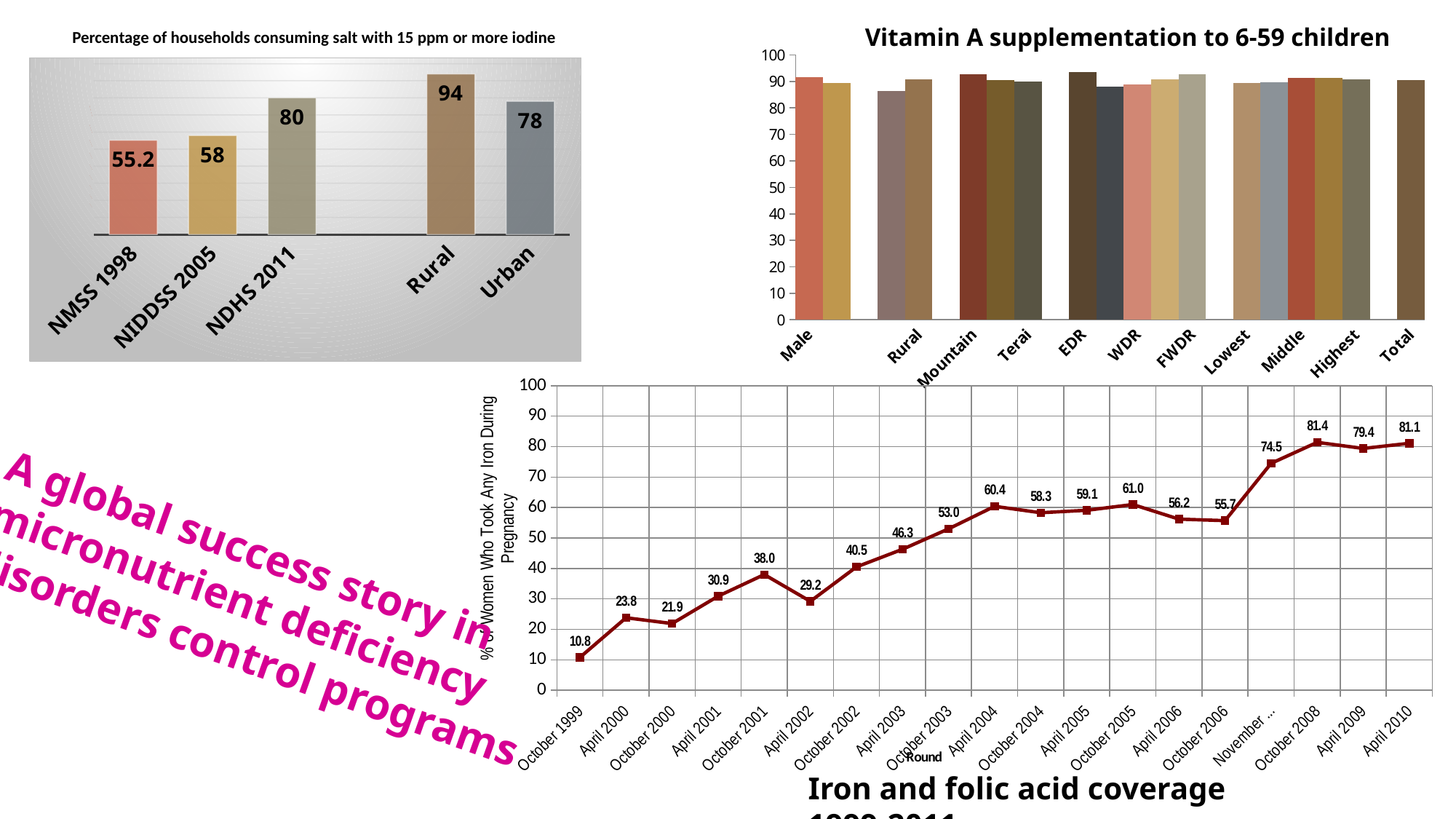
In the chart 'Percentage of households consuming salt with 15 ppm or more iodine', which category has the lowest value? NMSS 1998 In the chart 'Percentage of households consuming salt with 15 ppm or more iodine', which category has the highest value? Rural What kind of chart is 'Vitamin A supplementation to 6-59 children'? bar chart In the chart 'Vitamin A supplementation to 6-59 children', is the first bar for Rural greater or less than 90? less In the 'Iron and folic acid coverage' line chart, which round has the lowest value? October 1999 In the chart 'Percentage of households consuming salt with 15 ppm or more iodine', what is the difference between the Rural and Urban values? 16 In the 'Iron and folic acid coverage' line chart, which is larger, the value for April 2004 or October 2004? April 2004 In the chart 'Percentage of households consuming salt with 15 ppm or more iodine', what is the value for NDHS 2011? 80 In the 'Iron and folic acid coverage' line chart, what is the difference between the April 2010 value and the October 1999 value? 70.3 In the chart 'Vitamin A supplementation to 6-59 children', how many category labels are shown on the x axis? 11 In the 'Iron and folic acid coverage' line chart, what is the value for October 2008? 81.4 In the chart 'Percentage of households consuming salt with 15 ppm or more iodine', how many bars are shown? 5